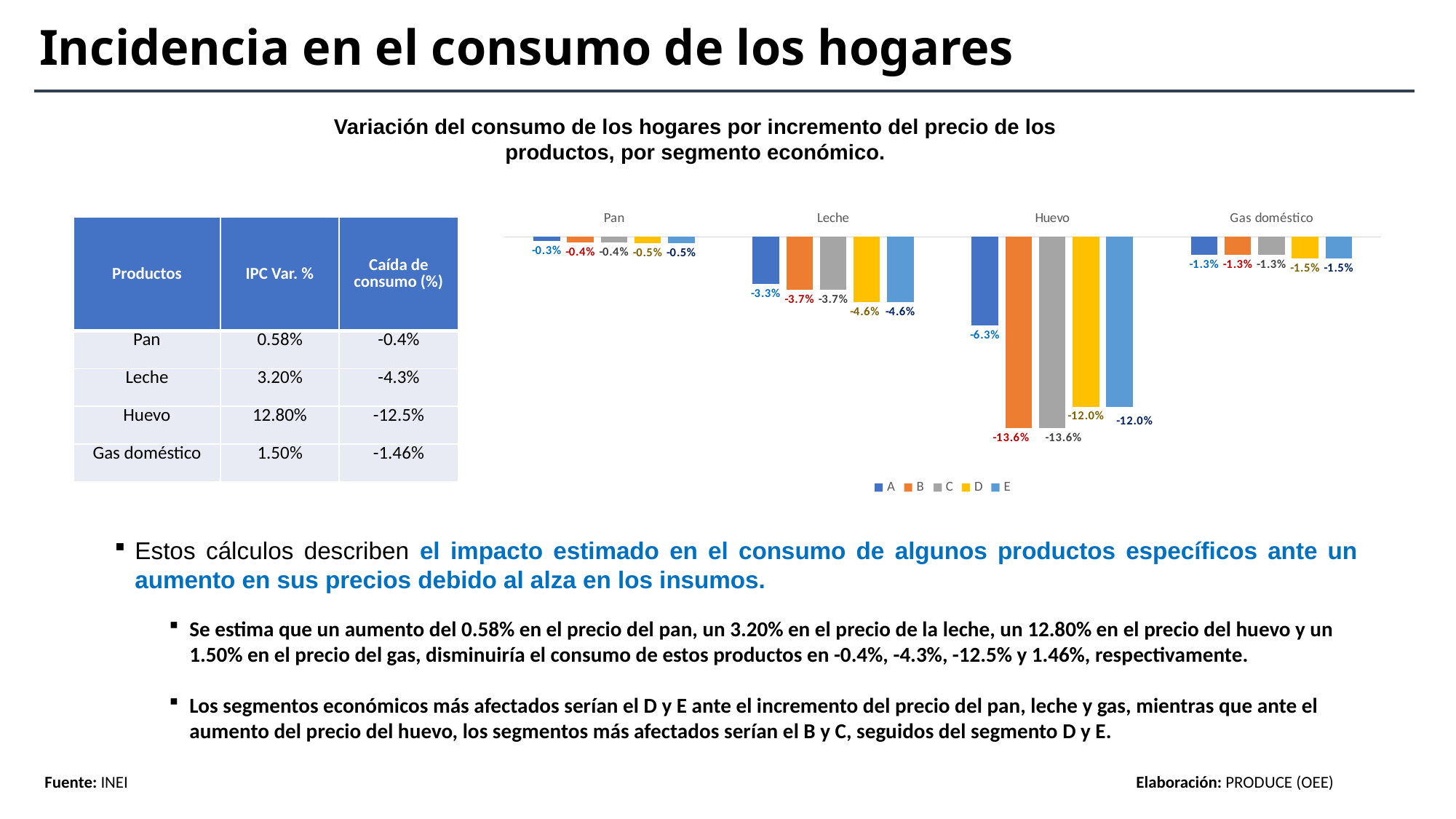
Which product category shows the largest consumption decline for series B? Huevo What is the value for series E in the Gas doméstico category? -1.5% What is the difference between the series B and series A values in the Huevo category? 7.3 percentage points What is the value for series A in the Huevo category? -6.3% How many series does the chart legend list? 5 Which series is shown in orange in the chart legend? B How many product categories are shown on the x axis of the chart? 4 What is the value for series D in the Leche category? -4.6% What type of chart is shown on the slide? bar chart What is the value for series B in the Huevo category? -13.6% In the Huevo category, which series has a larger decline, B or D? B What is the value for series A in the Pan category? -0.3%